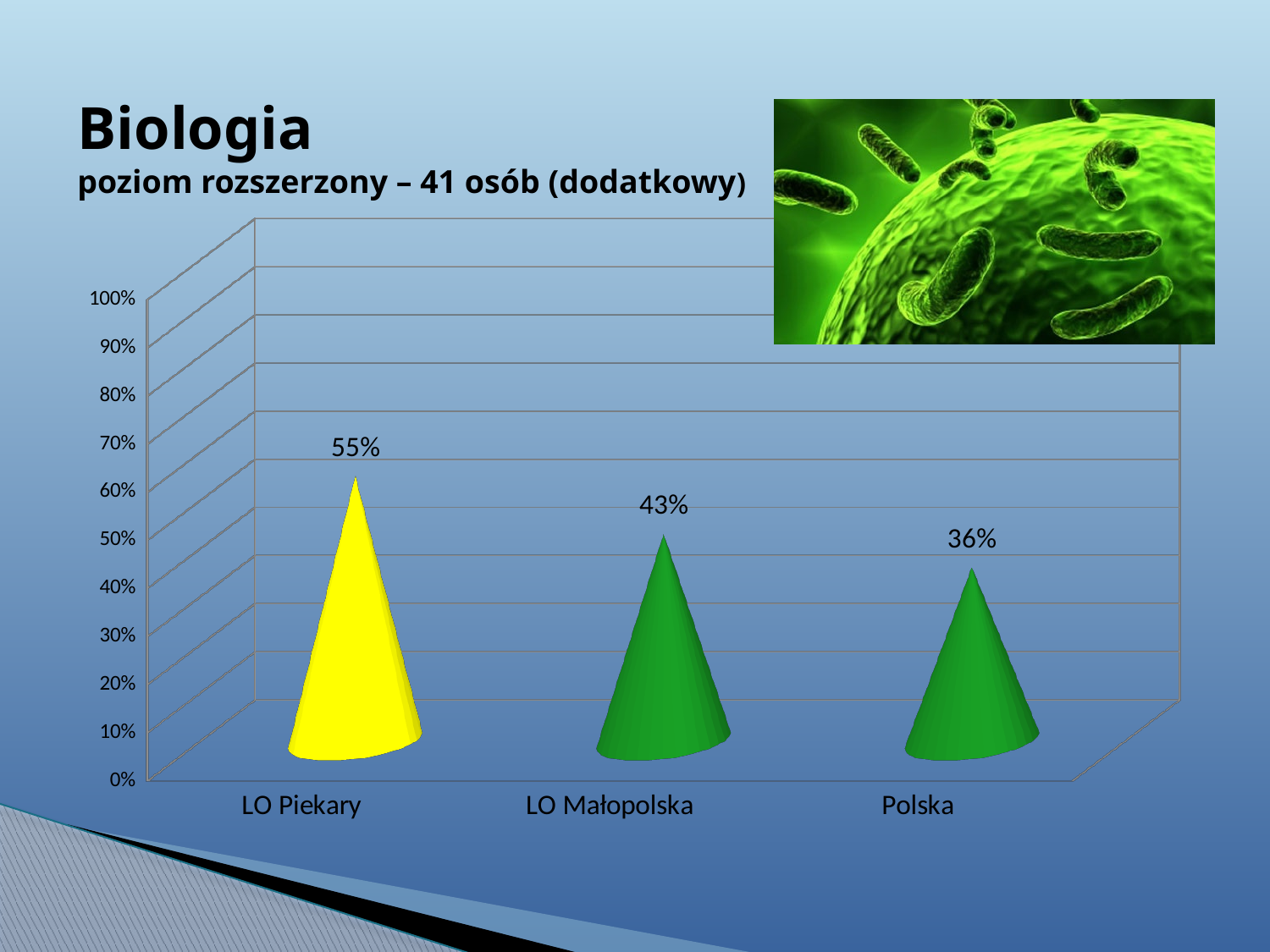
What is the value for Polska? 36% Is the value for Polska greater or less than 40%? less How many categories are shown on the x axis? 3 What is the value for LO Małopolska? 43% Which category has the highest value? LO Piekary What is the difference between the values for LO Piekary and Polska? 19% What is the difference between the values for LO Piekary and LO Małopolska? 12% Do the values rise or fall from left to right along the x axis? fall Which category has the lowest value? Polska What is the value for LO Piekary? 55% What colour is the bar for LO Piekary? yellow Which is larger, the value for LO Małopolska or the value for Polska? LO Małopolska